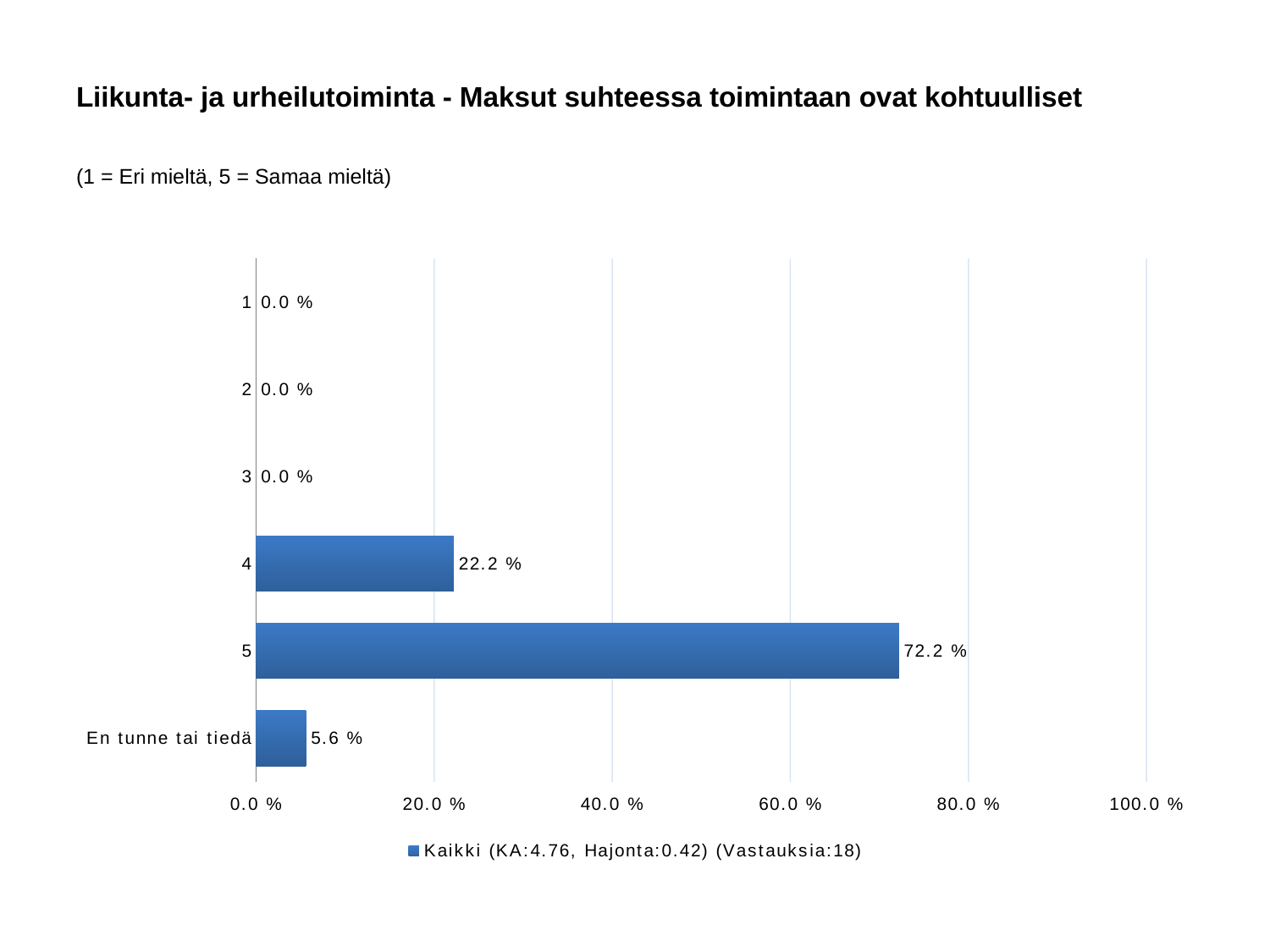
What kind of chart is shown on the slide? bar chart What is the difference between the values for category 5 and category 4? 50.0 % Is the value for category 5 greater or less than 60.0 %? greater Which is larger, the value for category 4 or for "En tunne tai tiedä"? 4 How many categories are shown on the chart? 6 What is the value for category 1? 0.0 % How many series does the legend list? 1 What is the value for category 4? 22.2 % Which category has the highest value? 5 How many responses (Vastauksia) does the legend report? 18 What is the value for category 5? 72.2 % What is the value for "En tunne tai tiedä"? 5.6 %